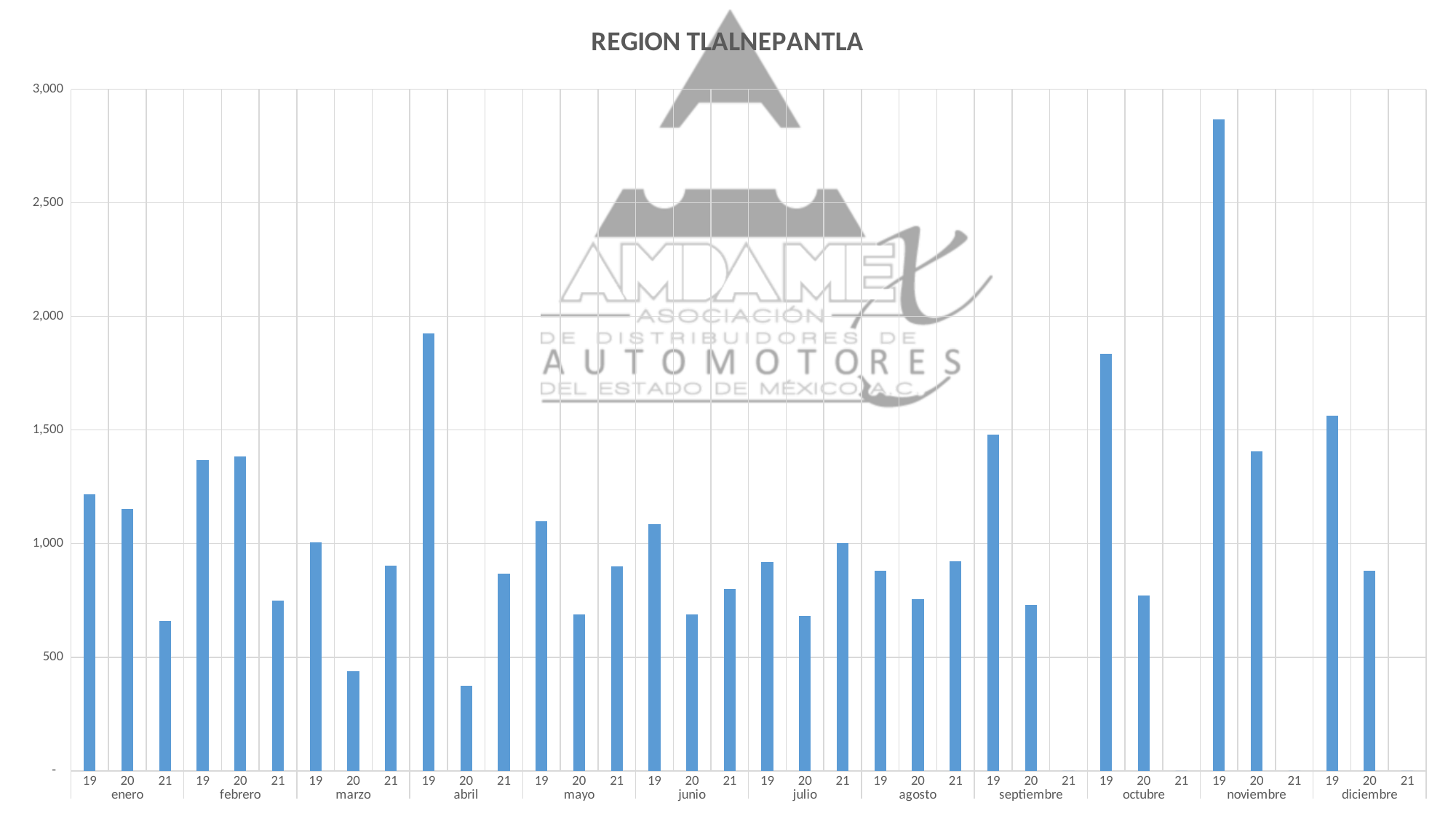
How many months are shown along the x axis? 12 How many year labels (19, 20, 21) appear under each month on the x axis? 3 Which is larger, the bar for marzo 20 or the bar for marzo 21? marzo 21 Within enero, do the values rise or fall from 19 to 21? fall What kind of chart is shown on the slide? bar chart Is the value for febrero 20 greater or less than 1,000? greater What is the title of the chart? REGION TLALNEPANTLA Is the value for abril 20 greater or less than 500? less Which month and year has the tallest bar? noviembre 19 Is the value for noviembre 19 greater or less than 2,500? greater Which is larger, the bar for abril 19 or the bar for abril 20? abril 19